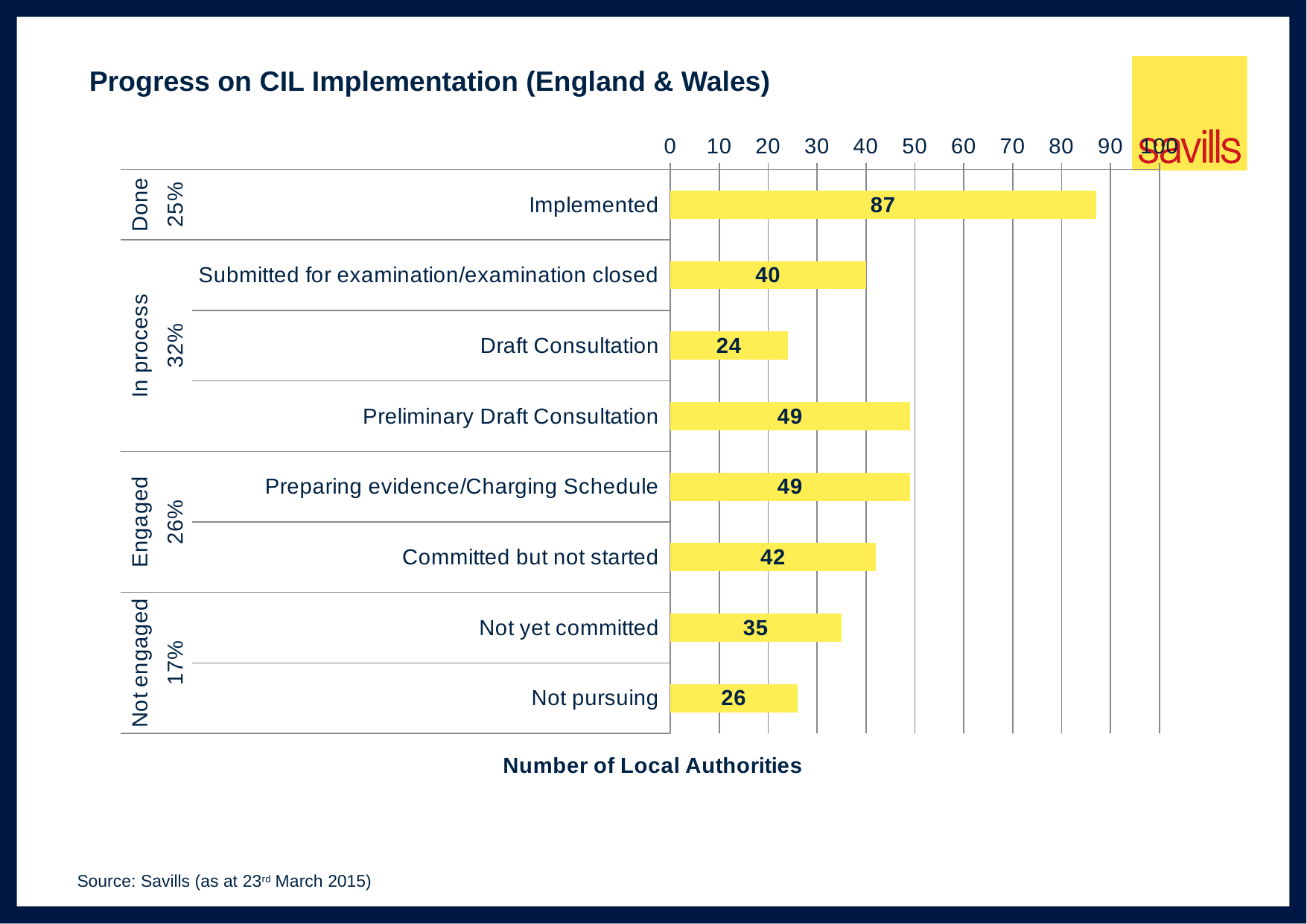
What is the total of Not yet committed and Not pursuing? 61 What is the value for Draft Consultation? 24 How many categories are plotted in the chart? 8 Which is larger, Committed but not started or Not pursuing? Committed but not started What is the x-axis title of the chart? Number of Local Authorities What is the value for Not yet committed? 35 What kind of chart is shown on the slide? bar chart Is the value for Preliminary Draft Consultation greater or less than 40? greater Which category has the highest number of local authorities? Implemented What is the difference between Implemented and Submitted for examination/examination closed? 47 Which category has the lowest number of local authorities? Draft Consultation How many local authorities have Implemented CIL? 87